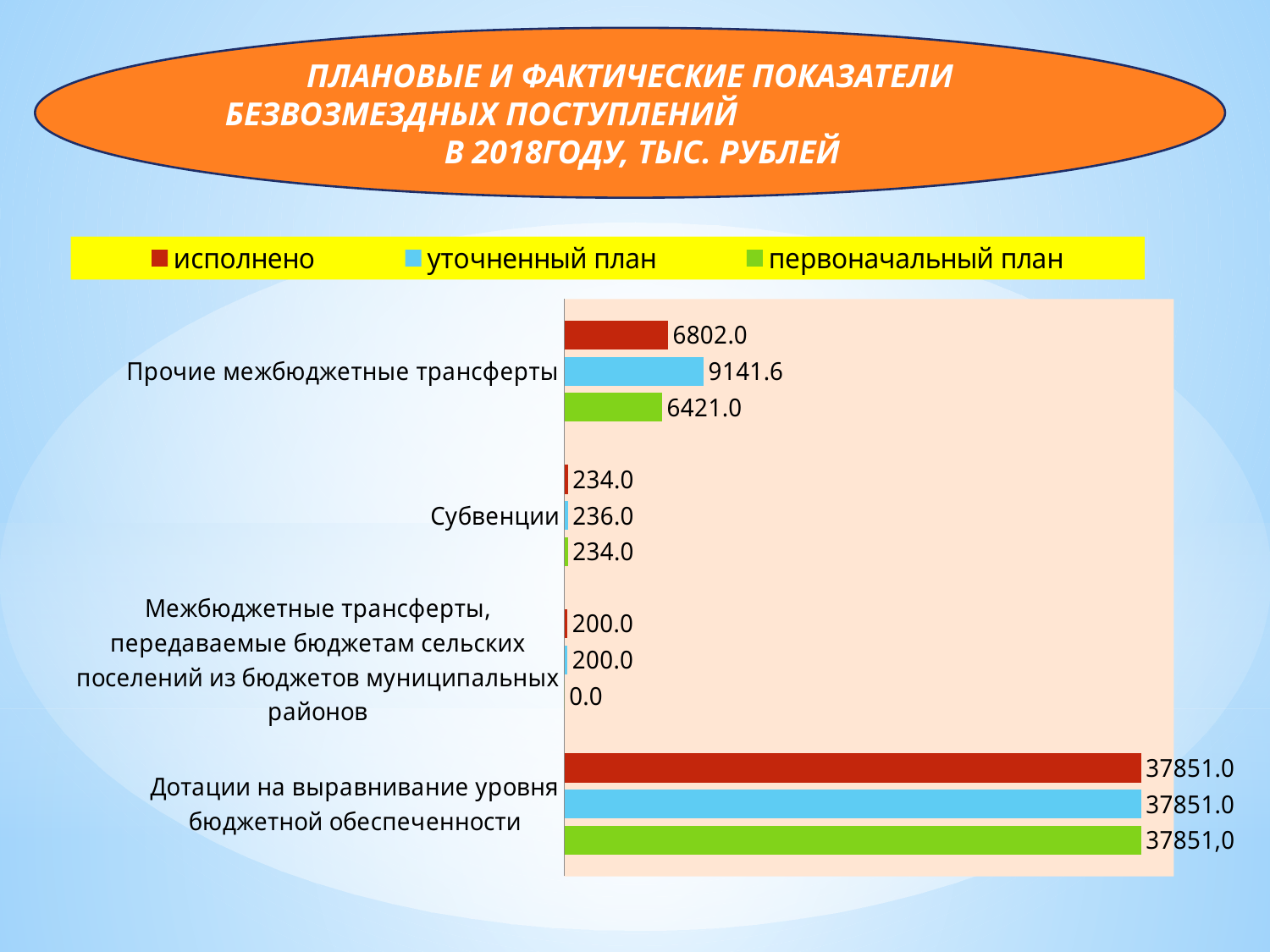
What is the value of 'уточненный план' for 'Прочие межбюджетные трансферты'? 9141.6 What is the difference between 'уточненный план' and 'исполнено' for 'Прочие межбюджетные трансферты'? 2339.6 How many series does the legend list? 3 How many categories are shown on the chart? 4 What is the value of 'первоначальный план' for 'Межбюджетные трансферты, передаваемые бюджетам сельских поселений из бюджетов муниципальных районов'? 0.0 Which category has the lowest 'первоначальный план' value? Межбюджетные трансферты, передаваемые бюджетам сельских поселений из бюджетов муниципальных районов Which category has the highest 'исполнено' value? Дотации на выравнивание уровня бюджетной обеспеченности What is the value of 'исполнено' for 'Дотации на выравнивание уровня бюджетной обеспеченности'? 37851.0 What is the value of 'уточненный план' for 'Субвенции'? 236.0 For 'Прочие межбюджетные трансферты', which is larger: 'исполнено' or 'первоначальный план'? исполнено What type of chart is shown on the slide? bar chart What is the value of 'исполнено' for 'Прочие межбюджетные трансферты'? 6802.0